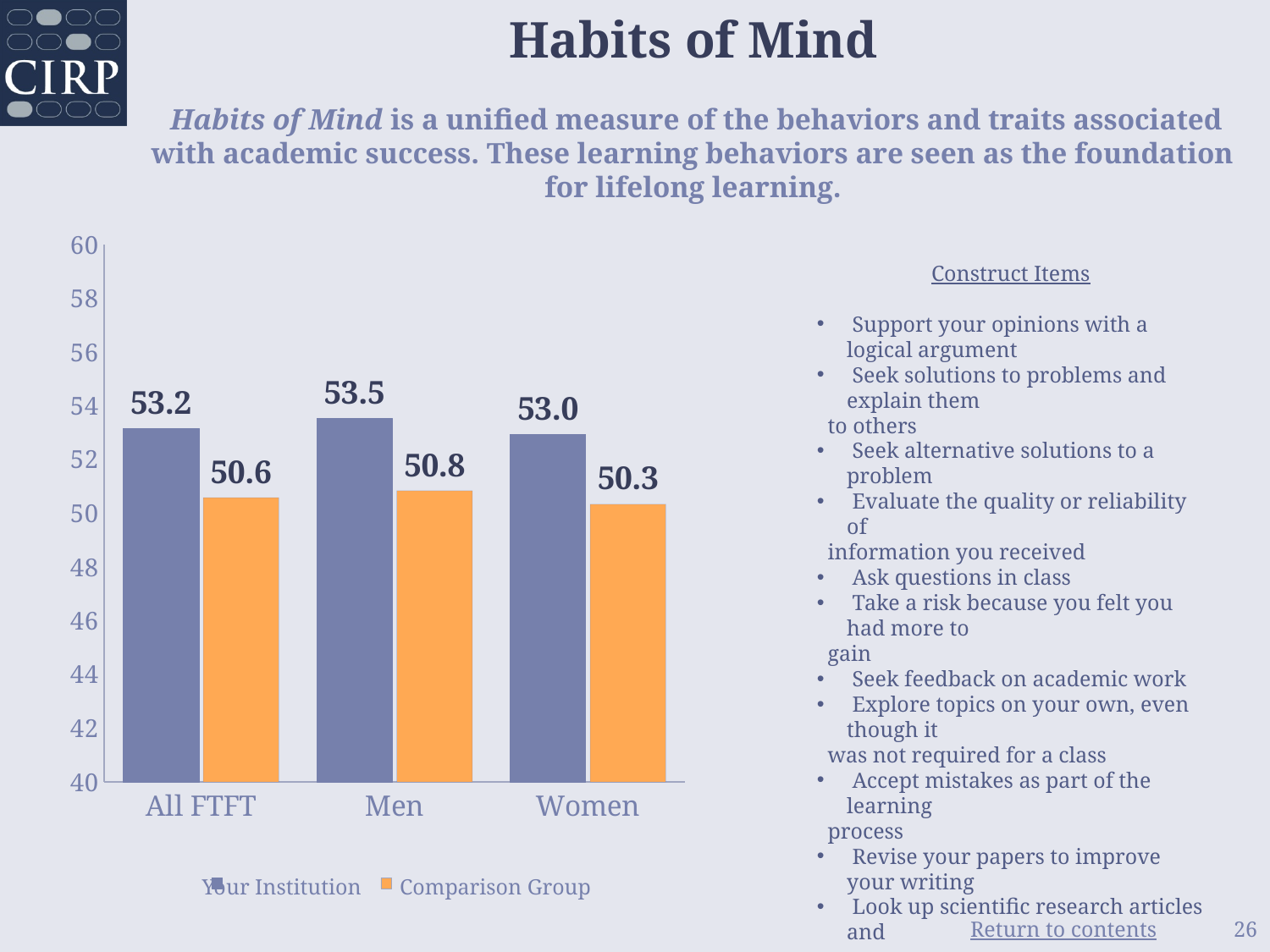
What is the value for Comparison Group in the Women category? 50.3 What is the value for Your Institution in the All FTFT category? 53.2 How many categories are shown on the x axis? 3 Which category has the highest Your Institution value? Men What is the difference between Your Institution and Comparison Group in the All FTFT category? 2.6 Is the value for Comparison Group in the Women category greater or less than 52? less Which category has the lowest Comparison Group value? Women What colour are the Comparison Group bars? orange What kind of chart is shown on the slide? bar chart How many series does the legend list? 2 What is the value for Your Institution in the Men category? 53.5 Which is larger in the Men category, Your Institution or Comparison Group? Your Institution